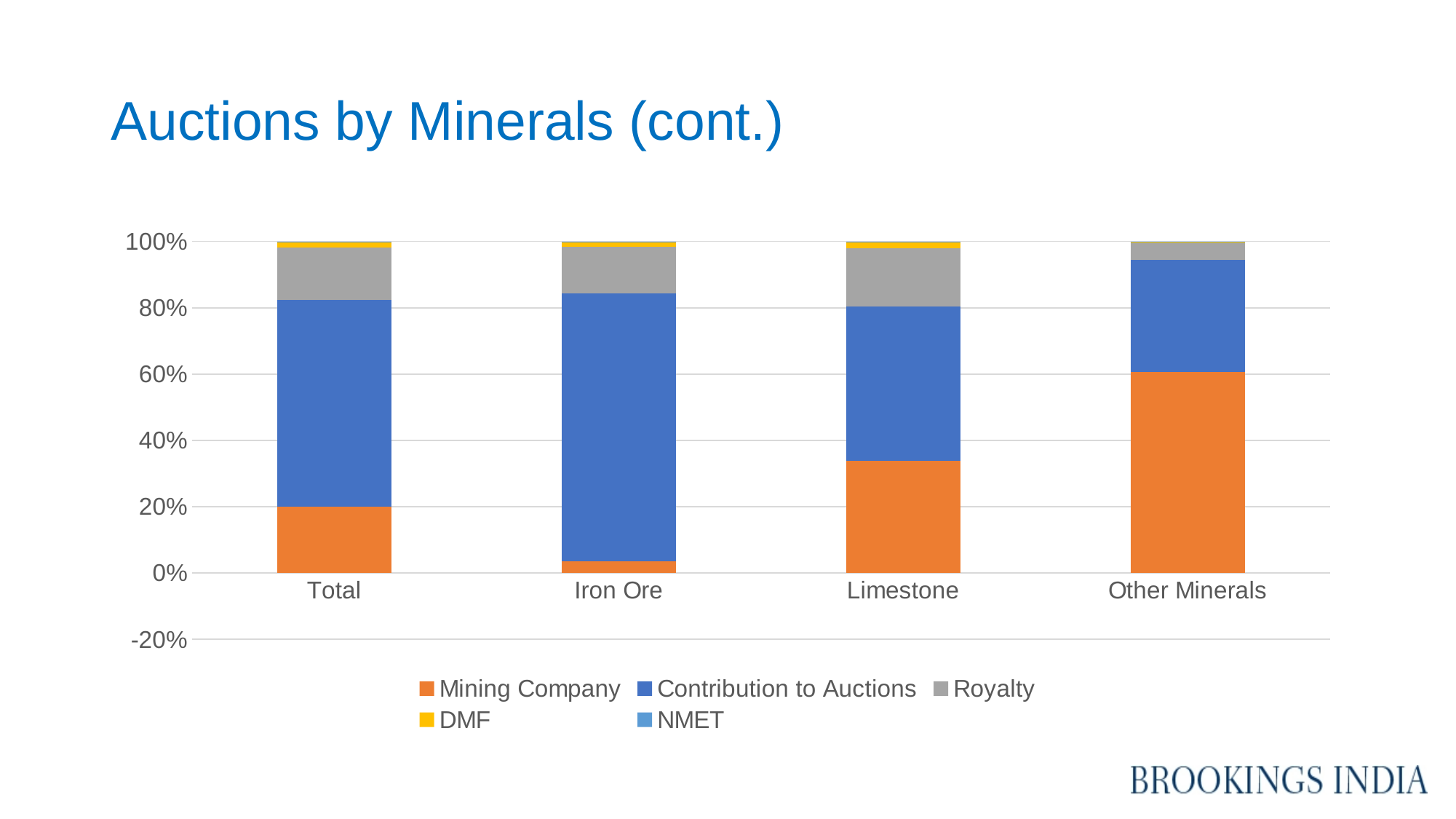
Which category has the smallest Contribution to Auctions share? Other Minerals How many categories are shown on the x axis of the chart? 4 Which category has the largest Mining Company share? Other Minerals Is the Mining Company share for Other Minerals greater or less than 40%? greater How many series does the chart's legend list? 5 Is the Mining Company share for Limestone greater or less than 20%? greater Which has the larger Mining Company share, Limestone or Total? Limestone Is the Mining Company share for Iron Ore greater or less than 20%? less Which category has the largest Contribution to Auctions share? Iron Ore Which category has the smallest Mining Company share? Iron Ore What kind of chart is shown on the slide? Stacked bar chart What is the title of the slide containing the chart? Auctions by Minerals (cont.)